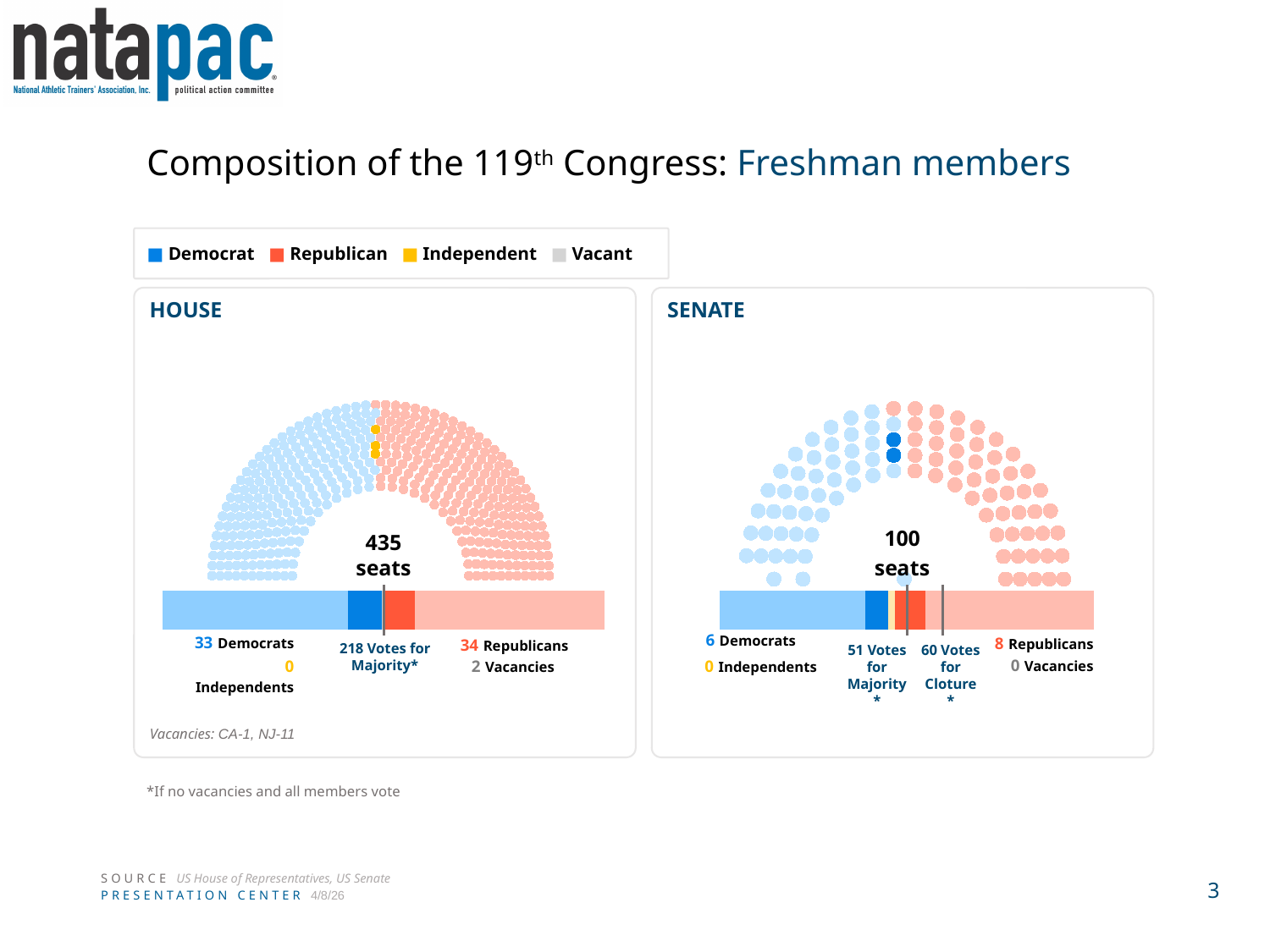
On the SENATE chart, how many freshman Republicans are shown? 8 On the HOUSE chart, how many freshman Democrats are shown? 33 On the HOUSE chart, which districts are listed as vacant? CA-1, NJ-11 On the SENATE chart, how many more freshman Republicans are there than freshman Democrats? 2 On the HOUSE chart, how many votes are needed for a majority? 218 On the HOUSE chart, how many vacancies are shown? 2 How many categories does the legend at the top of the slide list? 4 On the SENATE chart, how many freshman Democrats are shown? 6 On the HOUSE chart, which group has more freshman members, Democrats or Republicans? Republicans On the HOUSE chart, how many total seats are indicated? 435 seats On the SENATE chart, how many votes are needed for cloture? 60 On the HOUSE chart, how many freshman Republicans are shown? 34